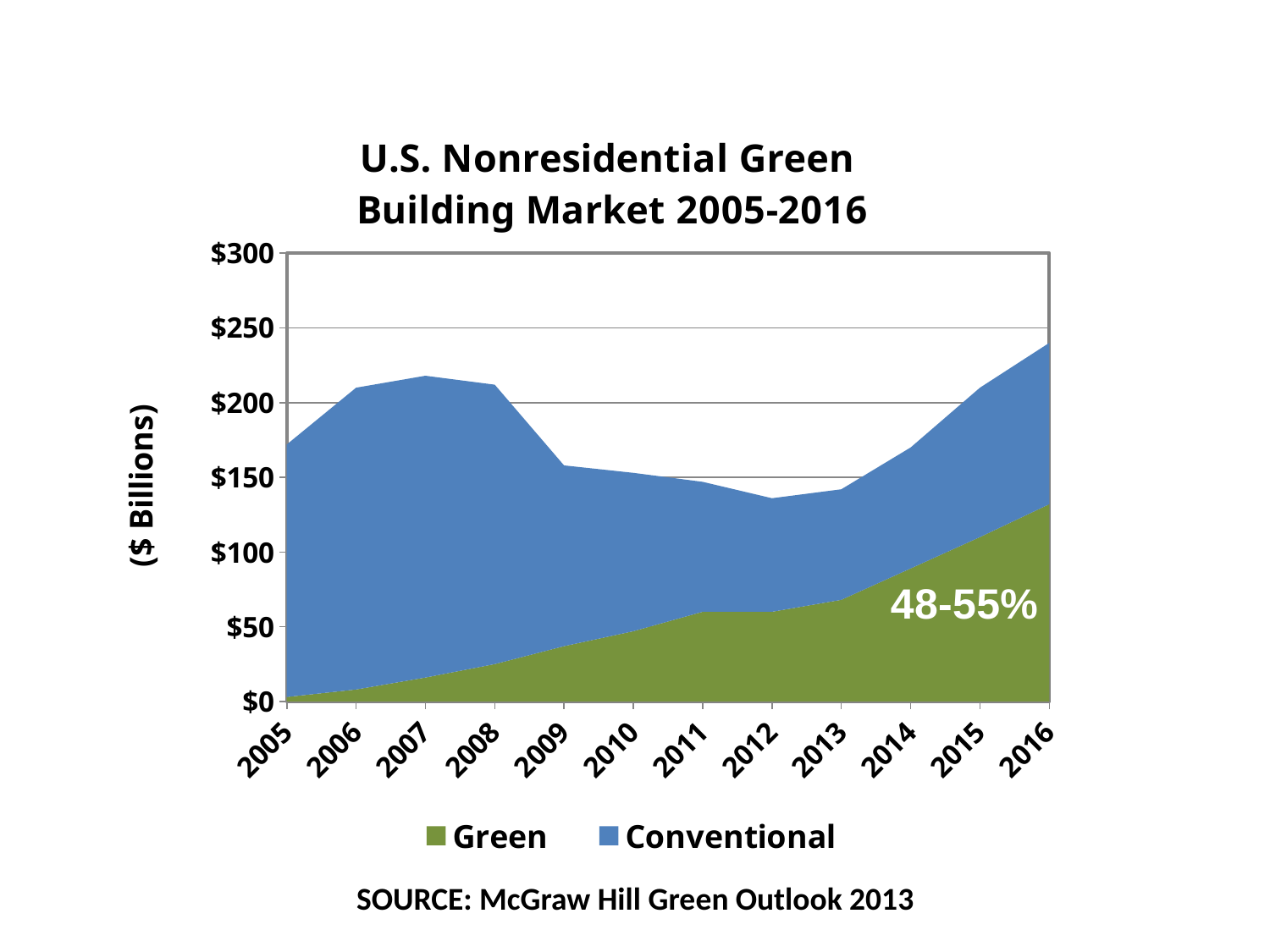
How many years are plotted along the x axis? 12 Is the total market value (Green plus Conventional) for 2007 greater or less than $200? greater Is the Green value for 2005 greater or less than $50? less Is the total market value (Green plus Conventional) for 2012 greater or less than $150? less Which series is shown in green? Green In which year is the Green series at its highest? 2016 In which year is the Green series at its lowest? 2005 How many series does the legend list? 2 What kind of chart is shown on the slide? Stacked area chart What is the y-axis label of the chart? ($ Billions) Does the Green series rise or fall from 2005 to 2016? rise